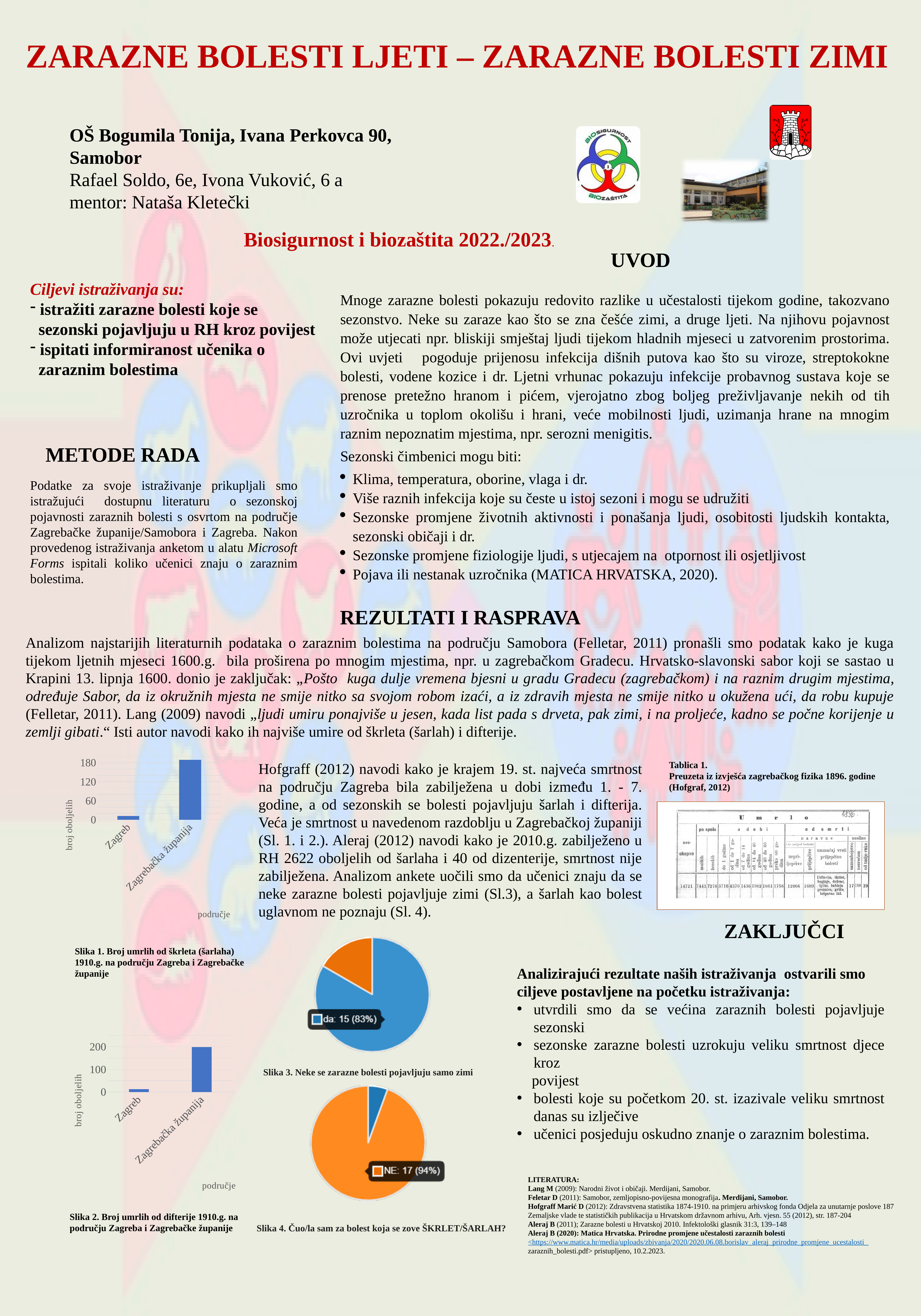
What kind of chart is Slika 1 (Broj umrlih od škrleta (šarlaha) 1910.g.)? bar chart In Slika 1 (Broj umrlih od škrleta), which area has the higher bar? Zagrebačka županija In Slika 4 (Čuo/la sam za bolest koja se zove ŠKRLET/ŠARLAH?), what percentage of the pie is the 'NE' slice? 94% In Slika 2 (Broj umrlih od difterije 1910.g.), is the value for Zagrebačka županija greater or less than 100? greater What kind of chart is Slika 4 (Čuo/la sam za bolest koja se zove ŠKRLET/ŠARLAH?)? pie chart In Slika 3 (Neke se zarazne bolesti pojavljuju samo zimi), how many respondents answered 'da'? 15 What is the y-axis label of Slika 1 (Broj umrlih od škrleta)? broj oboljelih What is the x-axis label of Slika 2 (Broj umrlih od difterije)? područje In Slika 2 (Broj umrlih od difterije), which area has the lower bar? Zagreb In Slika 3 (Neke se zarazne bolesti pojavljuju samo zimi), what percentage of the pie is the 'da' slice? 83% In Slika 1 (Broj umrlih od škrleta), is the value for Zagreb greater or less than 60? less How many areas are shown on the x axis of Slika 1 (Broj umrlih od škrleta)? 2